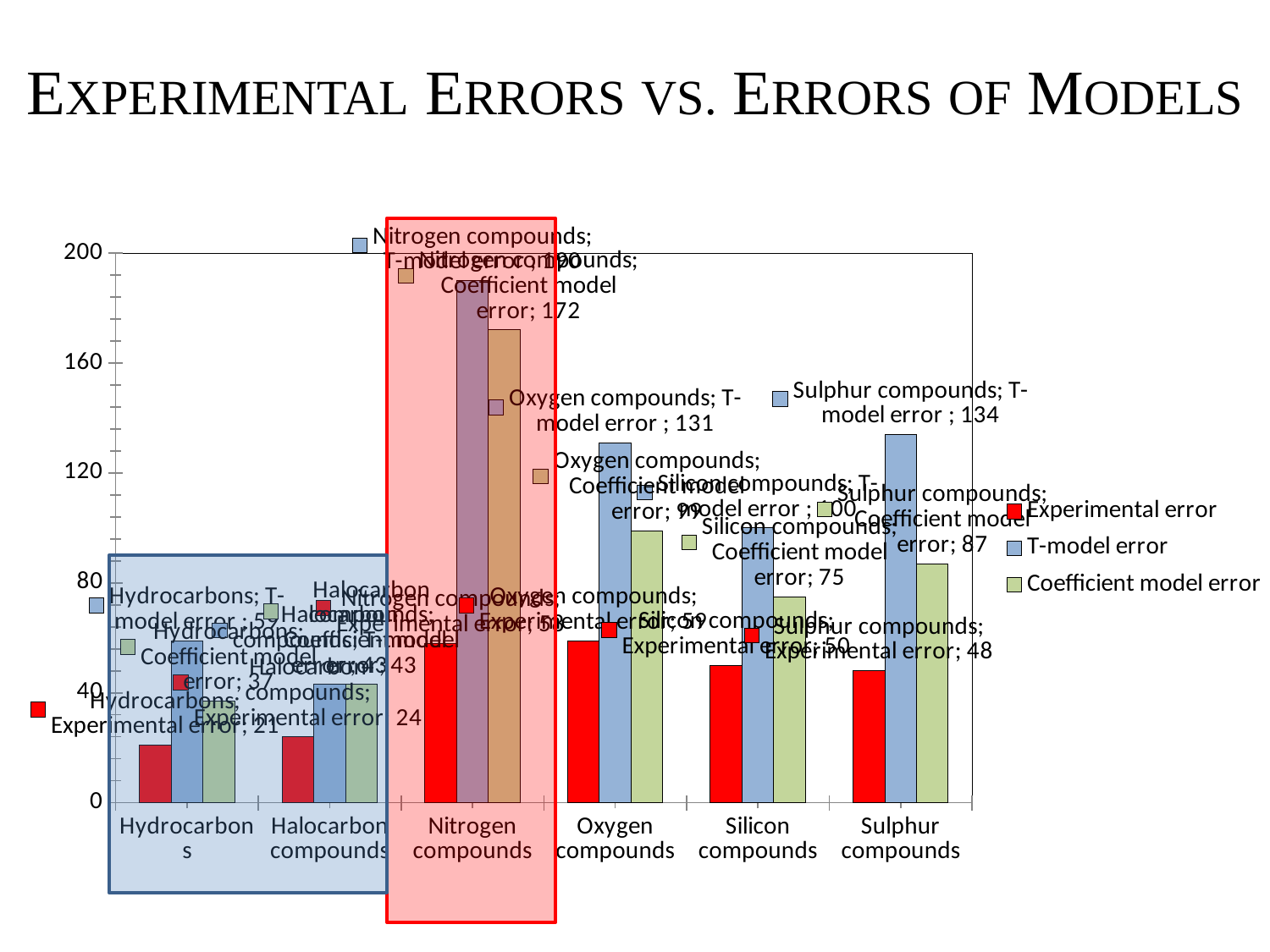
Is the Coefficient model error for Silicon compounds greater or less than 80? less What is the difference between the T-model error and the Coefficient model error for Nitrogen compounds? 18 What is the T-model error for Nitrogen compounds? 190 What is the Experimental error for Hydrocarbons? 21 What is the T-model error for Silicon compounds? 100 How many compound categories are shown on the x axis? 6 Which is larger, the T-model error for Silicon compounds or the T-model error for Sulphur compounds? Sulphur compounds How many series does the legend list? 3 What type of chart is shown on the slide? bar chart Which category has the highest Coefficient model error? Nitrogen compounds What is the Coefficient model error for Sulphur compounds? 87 Which category has the highest T-model error? Nitrogen compounds